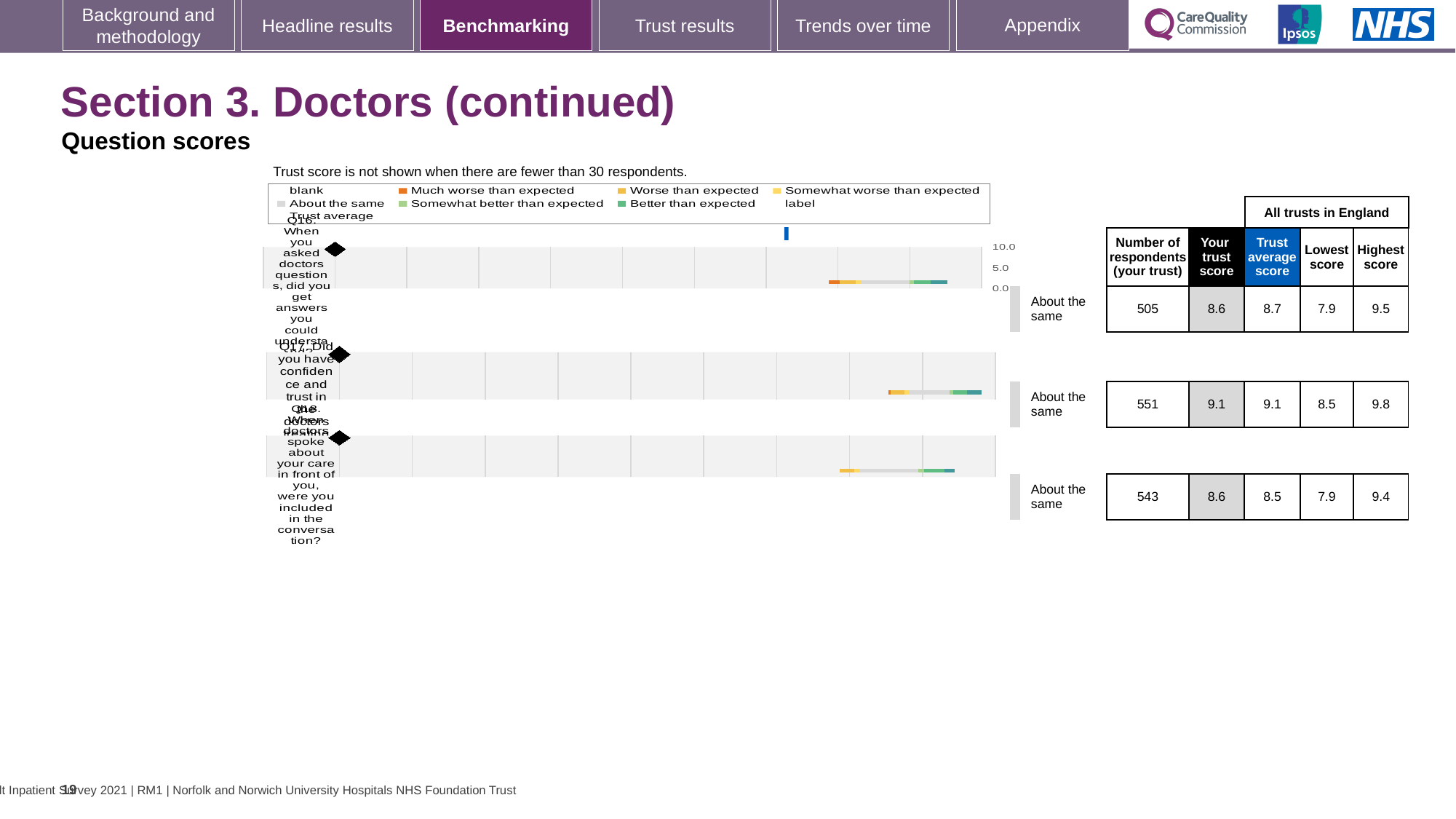
Is the trust score marker for Q17 greater or less than 5.0 on the axis? greater How many entries does the legend of the question scores chart list? 9 Which question has the lowest 'Highest score' across all trusts in England? Q18 What is the trust average score for Q16 (answers you could understand)? 8.7 What benchmark category is shown next to each of the three questions in the chart? About the same How many questions (categories) are plotted in the question scores chart? 3 What kind of chart is used to show the question scores on this slide? bar chart Which question has the highest 'Your trust score'? Q17 What is the difference between the highest score and the lowest score for Q16? 1.6 What is the trust score for Q17 (confidence and trust in the doctors)? 9.1 How many respondents answered Q18 (included in the conversation)? 543 For Q18, which is larger: your trust score or the trust average score? Your trust score